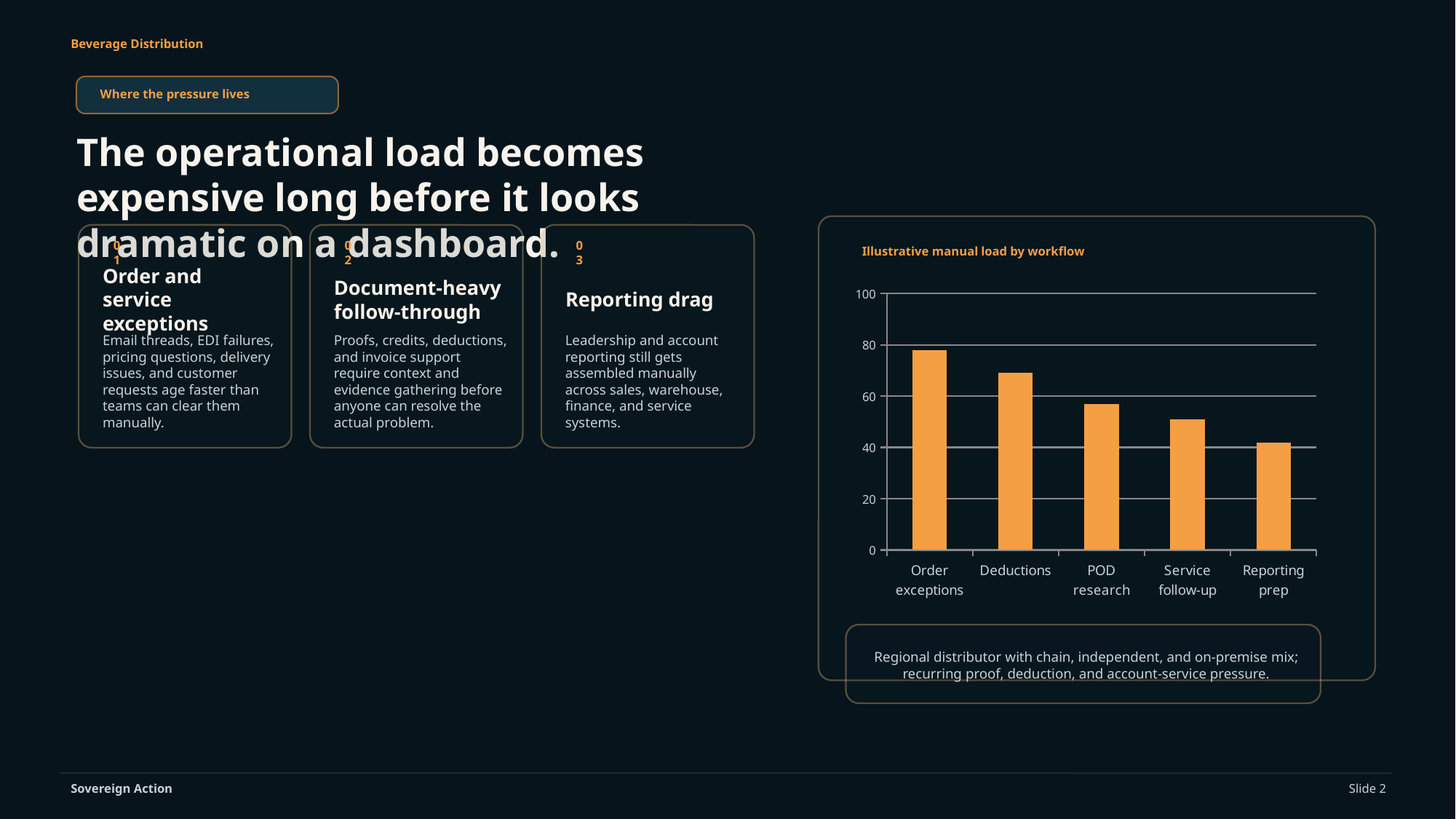
Is the value for Reporting prep greater or less than 60? less Which workflow has the lowest manual load in the chart? Reporting prep What is the highest value shown on the chart's vertical axis? 100 Do the bar values rise or fall from left to right across the x axis? fall What kind of chart is shown on the slide? bar chart Which has a higher value, Service follow-up or Reporting prep? Service follow-up Which has a higher value, Deductions or POD research? Deductions Is the value for Order exceptions greater or less than 60? greater What is the title of the chart? Illustrative manual load by workflow Is the value for Deductions greater or less than 80? less Which workflow has the highest manual load in the chart? Order exceptions How many workflow categories are plotted in the chart? 5